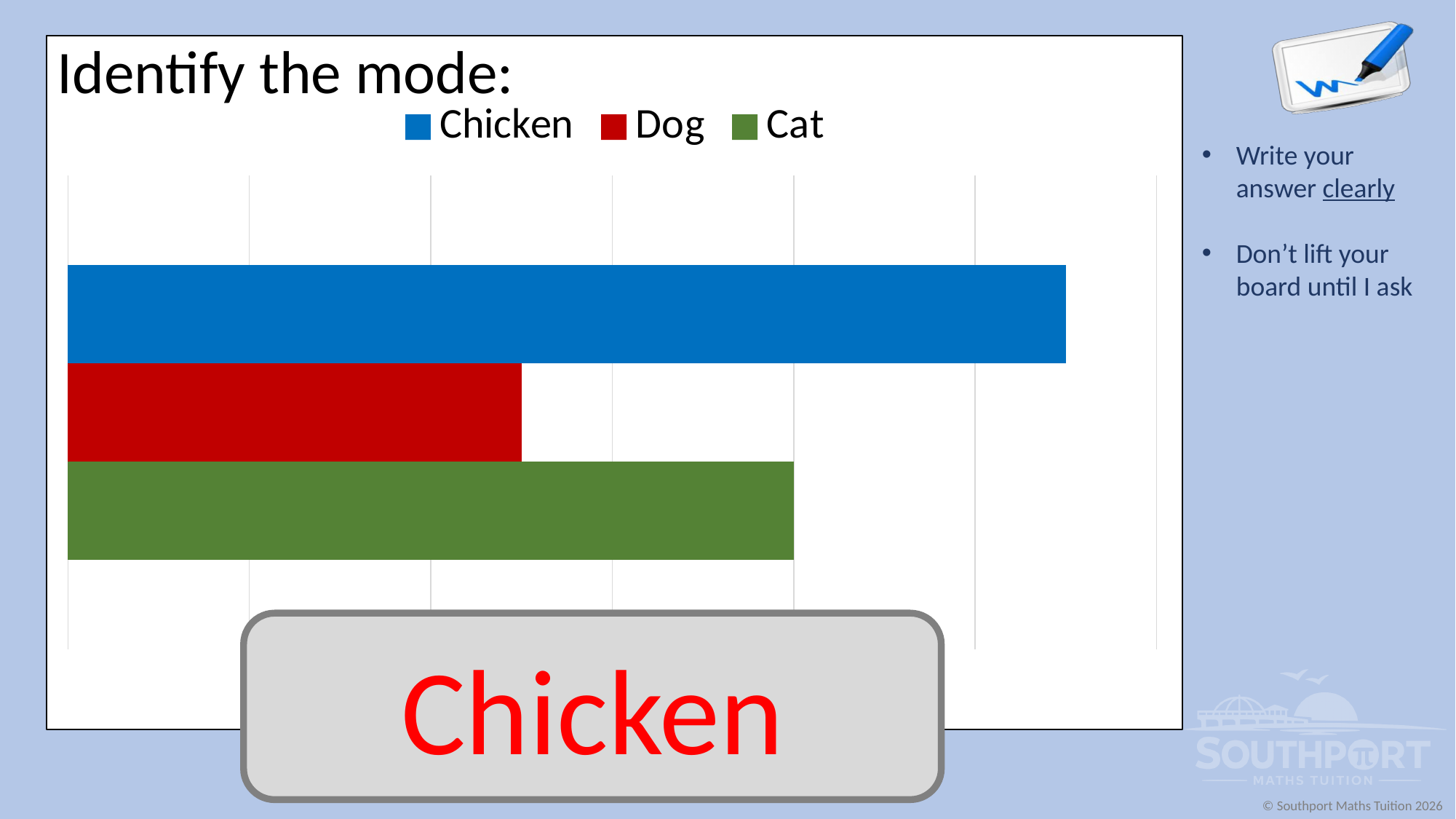
What are the three legend entries, in order? Chicken, Dog, Cat What colour is the bar for Dog? red How many bars are plotted on the chart? 3 Which category has the shortest bar? Dog Which category is the mode according to the chart? Chicken How many series does the legend list? 3 Which category has the longest bar? Chicken Which is larger, the value for Chicken or the value for Cat? Chicken Which is larger, the value for Cat or the value for Dog? Cat What kind of chart is shown on the slide? bar chart